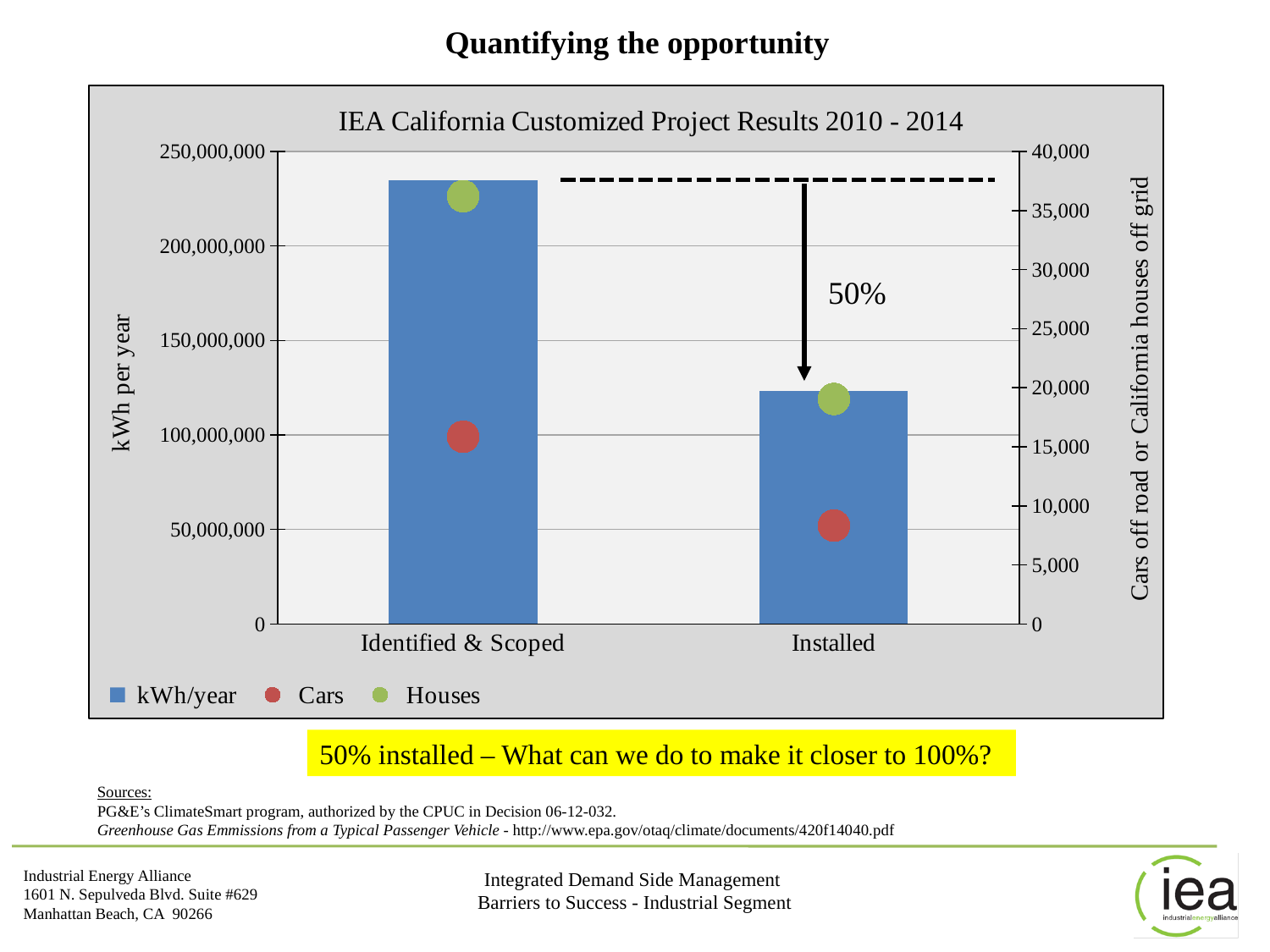
Is the kWh/year value for Installed greater or less than 150,000,000? less Is the kWh/year value for Identified & Scoped greater or less than 200,000,000? greater Is the kWh/year value for Installed greater or less than 100,000,000? greater What is the title of the chart? IEA California Customized Project Results 2010 - 2014 Which category has the higher kWh/year bar? Identified & Scoped Which category has the lower kWh/year bar? Installed What is the title of the left vertical axis? kWh per year How many categories are shown on the x axis of the chart? 2 What type of chart is shown on the slide? bar chart How many series does the chart legend list? 3